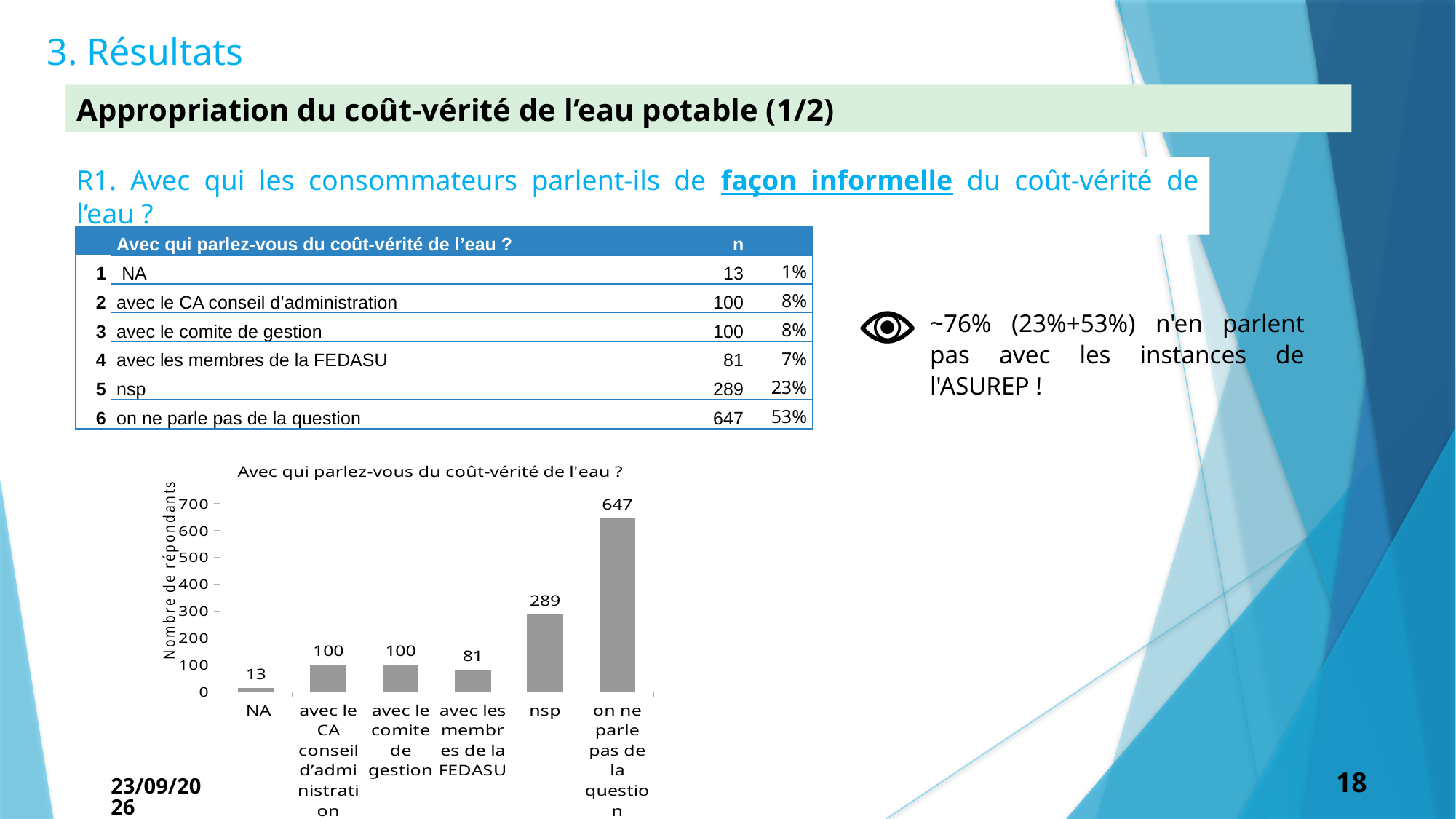
What is the value for 'nsp' in the chart? 289 Which category has the lowest value in the chart? NA Which is larger: the value for 'nsp' or the value for 'avec le comite de gestion'? nsp What type of chart is shown on the slide? bar chart How many categories are shown on the x axis of the chart? 6 What is the value for 'avec les membres de la FEDASU' in the chart? 81 What is the difference between the values for 'on ne parle pas de la question' and 'nsp'? 358 What is the label of the vertical axis of the chart? Nombre de répondants What is the title of the chart? Avec qui parlez-vous du coût-vérité de l'eau ? Which category has the highest value in the chart? on ne parle pas de la question What is the difference between the values for 'avec le CA conseil d'administration' and 'avec les membres de la FEDASU'? 19 What is the value for 'NA' in the chart? 13